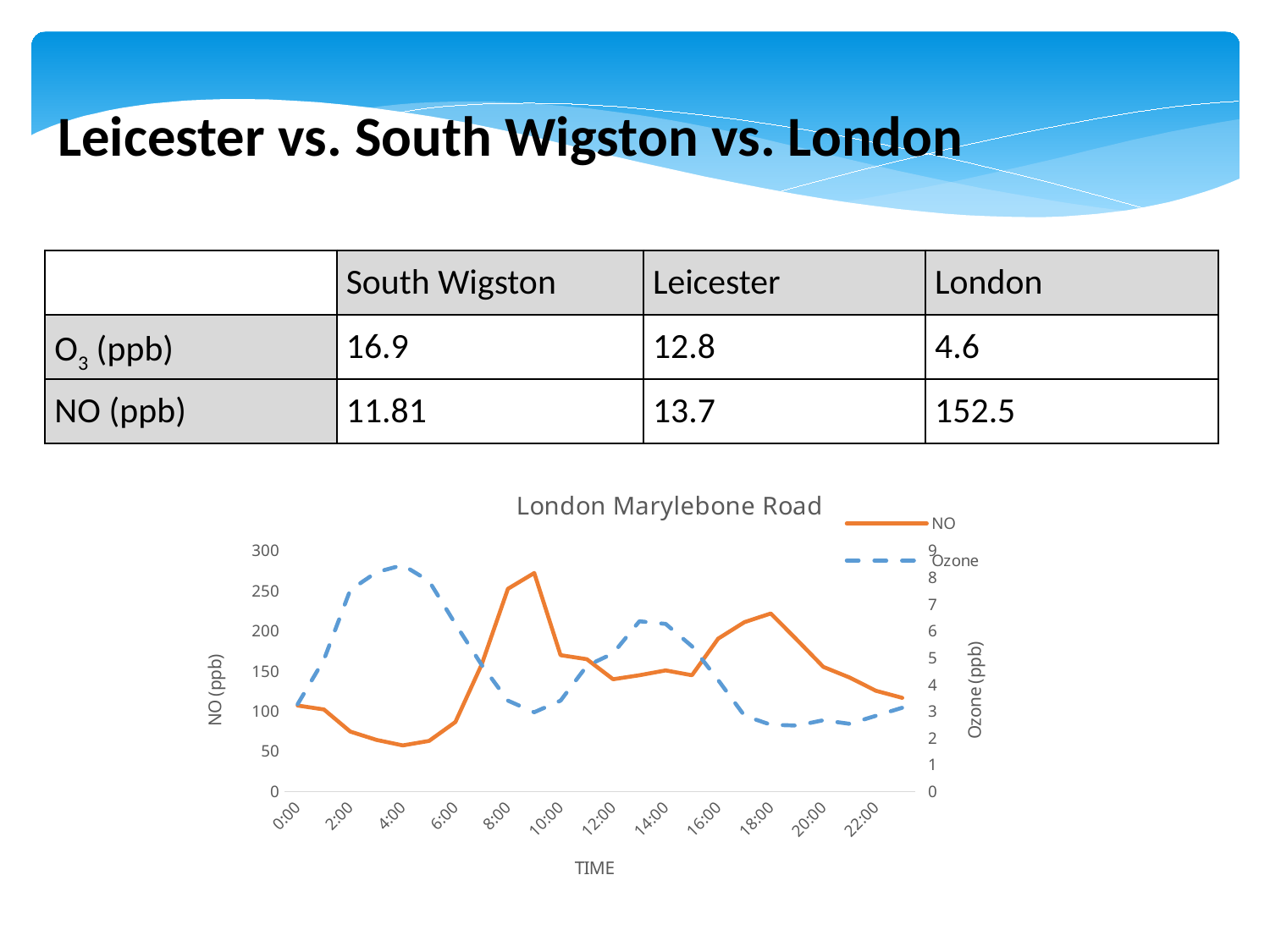
Which series is drawn with a dashed line? Ozone How many series does the chart's legend list? 2 Is the Ozone value at 4:00 greater or less than 7? greater How many time labels are shown along the x axis? 12 What kind of chart is shown on the slide? Line chart At what time does the Ozone series reach its highest value? 4:00 What is the title of the chart? London Marylebone Road Does the Ozone series rise or fall between 0:00 and 4:00? rise Is the NO value at 4:00 greater or less than 100? less Is the Ozone value at 20:00 greater or less than 3? less